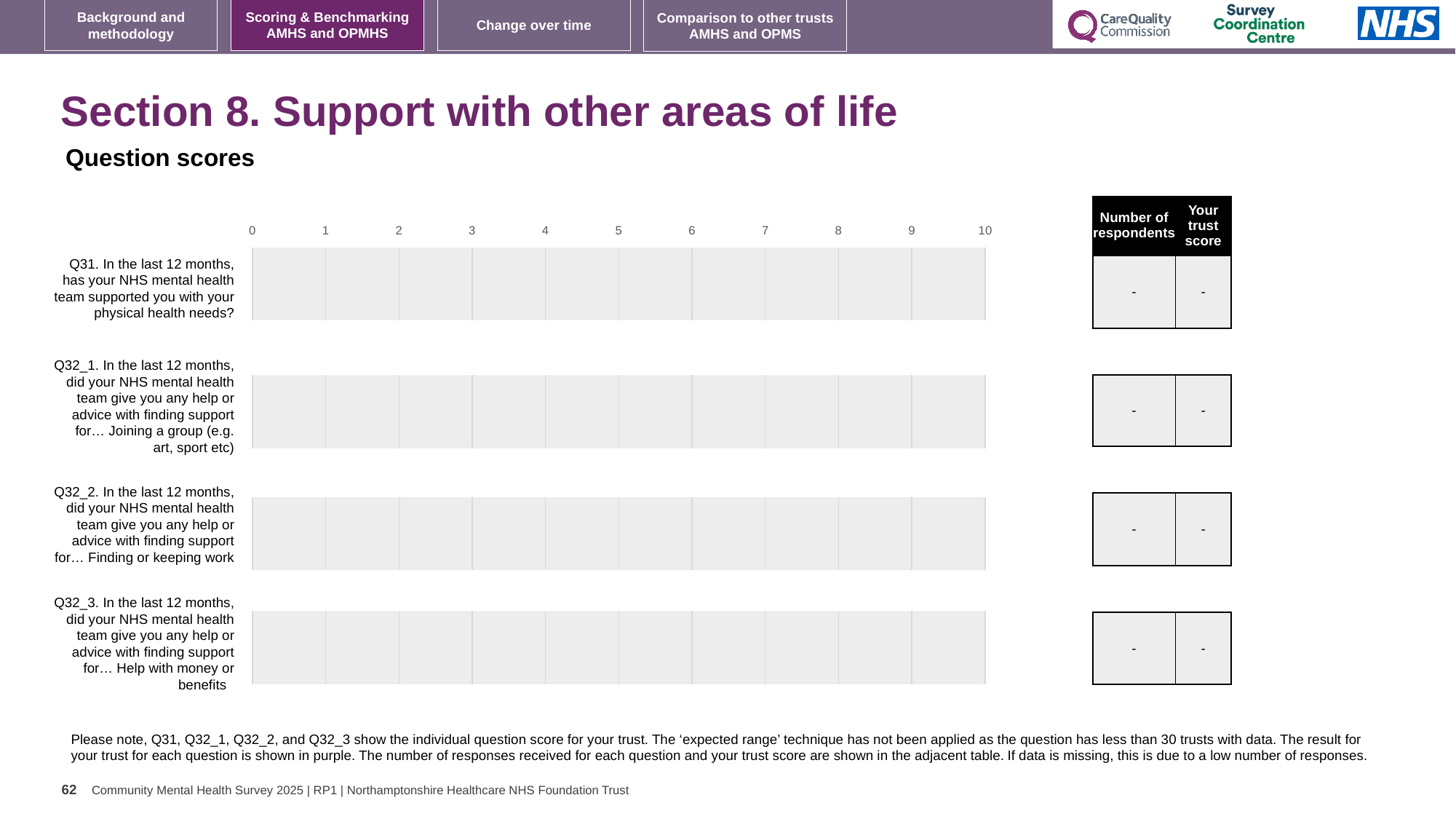
What is the trust score shown in the table for Q32_3 (Help with money or benefits)? - What is the trust score shown in the table for Q32_1 (Joining a group)? - What kind of chart is used to show the question scores? bar chart How many survey questions are listed as categories on the chart? 4 Are any bars plotted on the chart for the four questions? No What is the number of respondents shown in the table for Q31? - What is the highest value shown on the chart's horizontal axis? 10